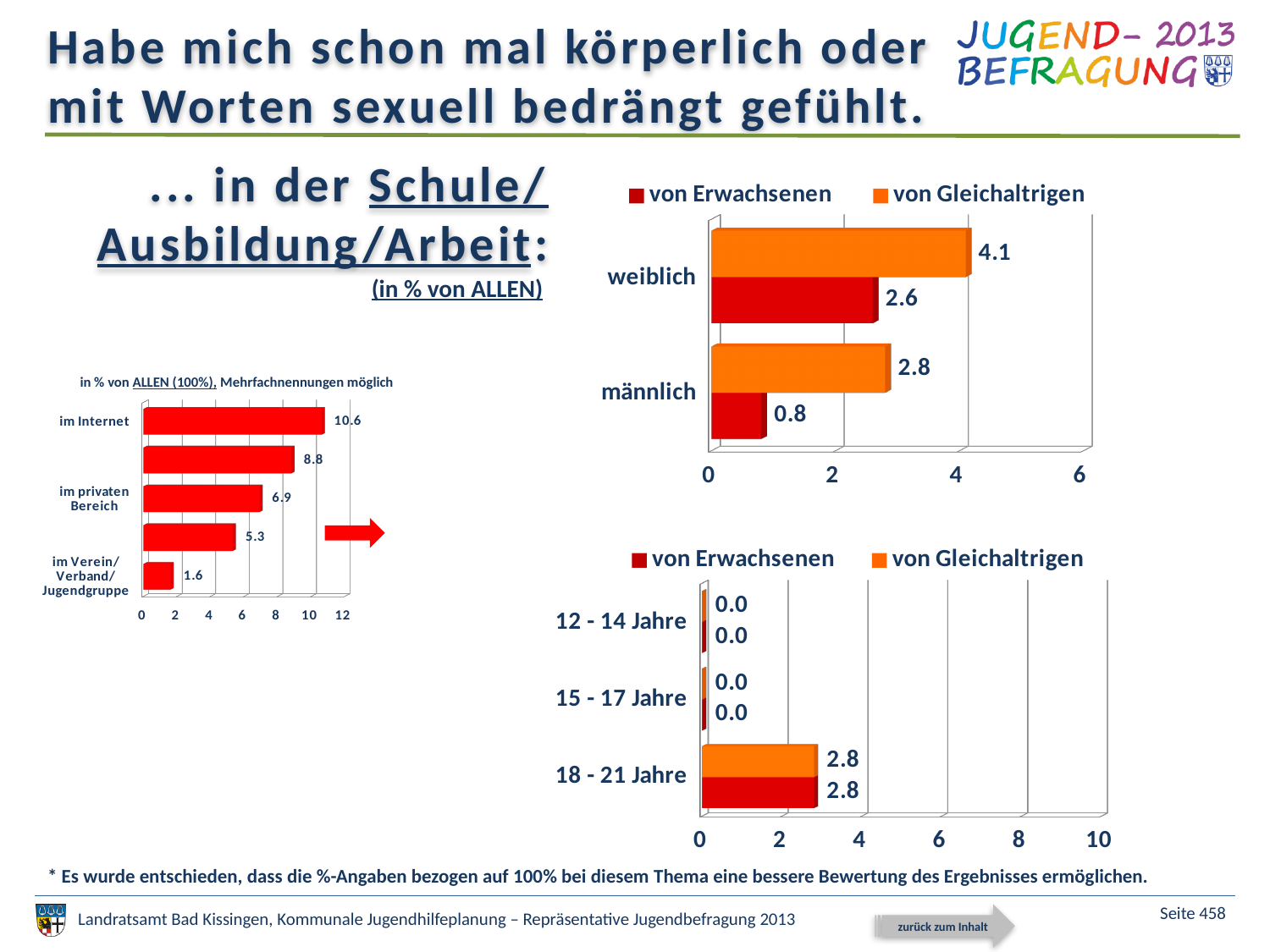
In the top right chart (weiblich/männlich), what is the value for weiblich in the series 'von Gleichaltrigen'? 4.1 In the small chart on the left, what is the value for 'im Verein/Verband/Jugendgruppe'? 1.6 In the top right chart (weiblich/männlich), what is the value for männlich in the series 'von Erwachsenen'? 0.8 In the bottom right chart (age groups), what is the value for 18 - 21 Jahre in the series 'von Erwachsenen'? 2.8 In the top right chart (weiblich/männlich), what is the difference between the 'von Gleichaltrigen' and 'von Erwachsenen' values for weiblich? 1.5 What kind of chart is the top right chart (weiblich/männlich)? bar chart In the small chart on the left, what is the value for 'im Internet'? 10.6 In the top right chart (weiblich/männlich), how many series does the legend list? 2 In the top right chart (weiblich/männlich), which is larger for männlich: 'von Erwachsenen' or 'von Gleichaltrigen'? von Gleichaltrigen In the bottom right chart (age groups), how many age categories are shown? 3 In the bottom right chart (age groups), what is the value for 12 - 14 Jahre in the series 'von Gleichaltrigen'? 0.0 In the bottom right chart (age groups), which age group has the highest value in the series 'von Gleichaltrigen'? 18 - 21 Jahre